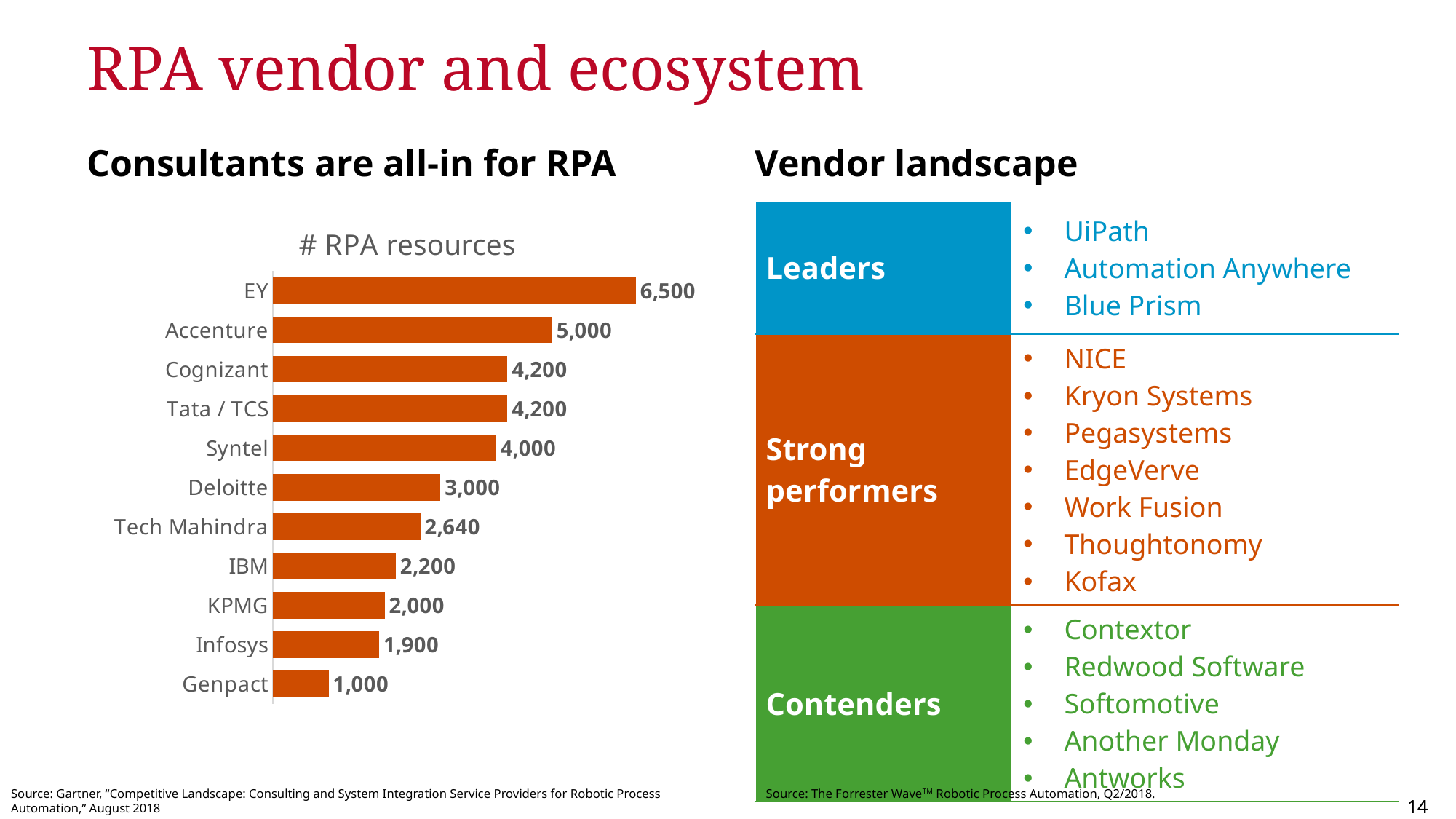
What is the difference in RPA resources between IBM and Infosys? 300 Which consultant has the highest number of RPA resources? EY What type of chart is used to show # RPA resources? Bar chart Which consultant has the lowest number of RPA resources? Genpact What is the title of the chart on the left side of the slide? # RPA resources Which has more RPA resources, KPMG or Tech Mahindra? Tech Mahindra What is the difference in RPA resources between EY and Accenture? 1,500 What is the value shown for Deloitte in the # RPA resources chart? 3,000 Which has more RPA resources, Syntel or Deloitte? Syntel How many RPA resources does EY have according to the chart? 6,500 How many consultants are listed in the # RPA resources chart? 11 How many RPA resources does Tech Mahindra have? 2,640